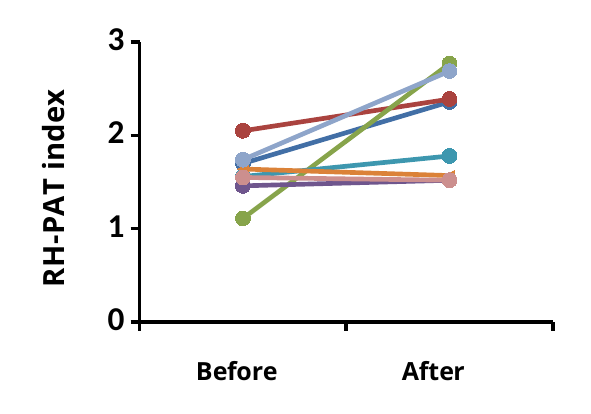
Which x-axis category contains the lowest plotted point? Before What kind of chart is shown on the slide? line chart Is the highest value at Before greater or less than 3? less Is the lowest value at Before greater or less than 2? less Is the highest value at After greater or less than 2? greater What is the title of the y axis? RH-PAT index Do most of the lines rise or fall from Before to After? rise How many categories are shown on the x axis? 2 What are the two category labels on the x axis? Before and After Which x-axis category contains the highest plotted point? After